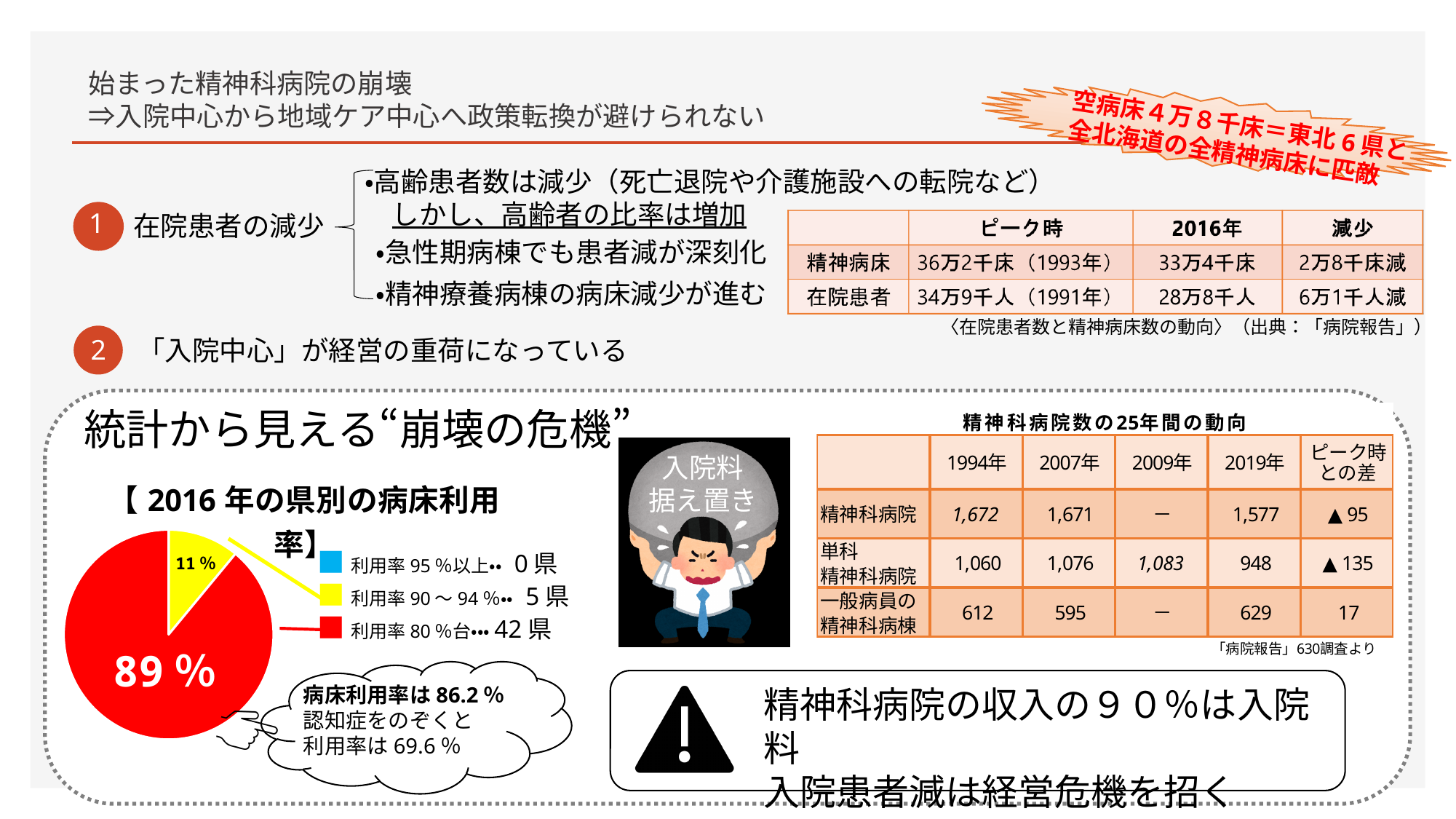
How many entries does the legend of the pie chart list? 3 In the pie chart, what share is shown for 利用率90～94%? 11% According to the pie chart legend, how many prefectures have 利用率95%以上? 0県 According to the pie chart legend, how many prefectures have 利用率80%台? 42県 Which category has the largest slice in the pie chart? 利用率80%台 In the pie chart, what share is shown for 利用率80%台? 89% Which slice is larger in the pie chart: 利用率80%台 or 利用率90～94%? 利用率80%台 What kind of chart is shown on the slide under 「2016年の県別の病床利用率」? Pie chart What is the difference in percentage points between the 89% slice and the 11% slice in the pie chart? 78 percentage points According to the pie chart legend, how many prefectures have 利用率90～94%? 5県 What colour is the largest slice of the pie chart? Red What is the total of the two labelled slices (89% and 11%) in the pie chart? 100%